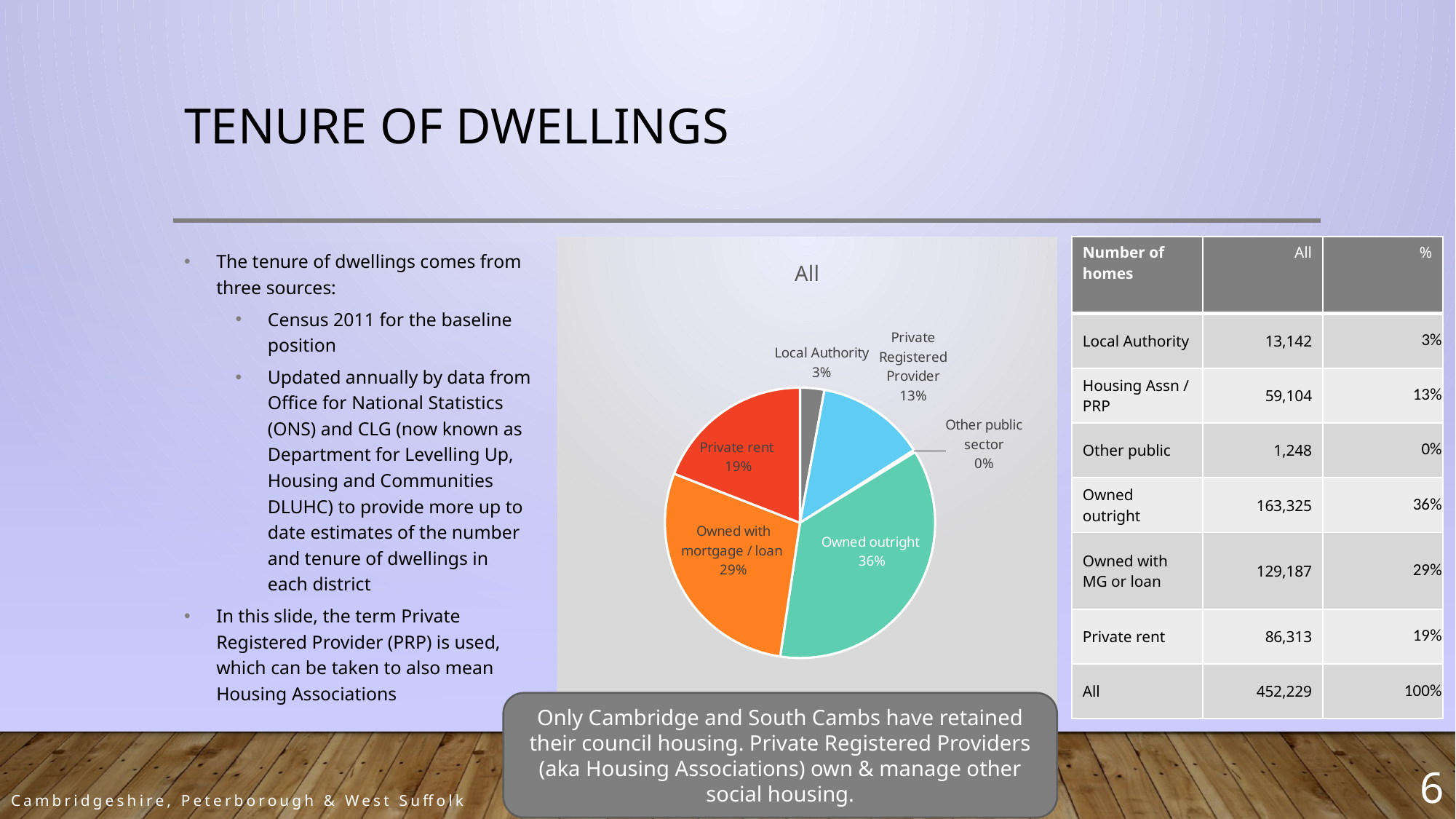
What is the title of the pie chart? All Which is larger in the pie chart, Private rent or Private Registered Provider? Private rent What share of the pie does Owned outright represent? 36% How many slices does the pie chart have? 6 What percentage is shown for Local Authority in the pie chart? 3% What percentage is shown for Private Registered Provider? 13% What percentage is shown for Private rent in the pie chart? 19% What is the difference in percentage points between Owned outright and Owned with mortgage / loan? 7 What kind of chart is shown on the slide? pie chart Which slice of the pie chart is the smallest? Other public sector What percentage is shown for Owned with mortgage / loan? 29% Which slice of the pie chart is the largest? Owned outright